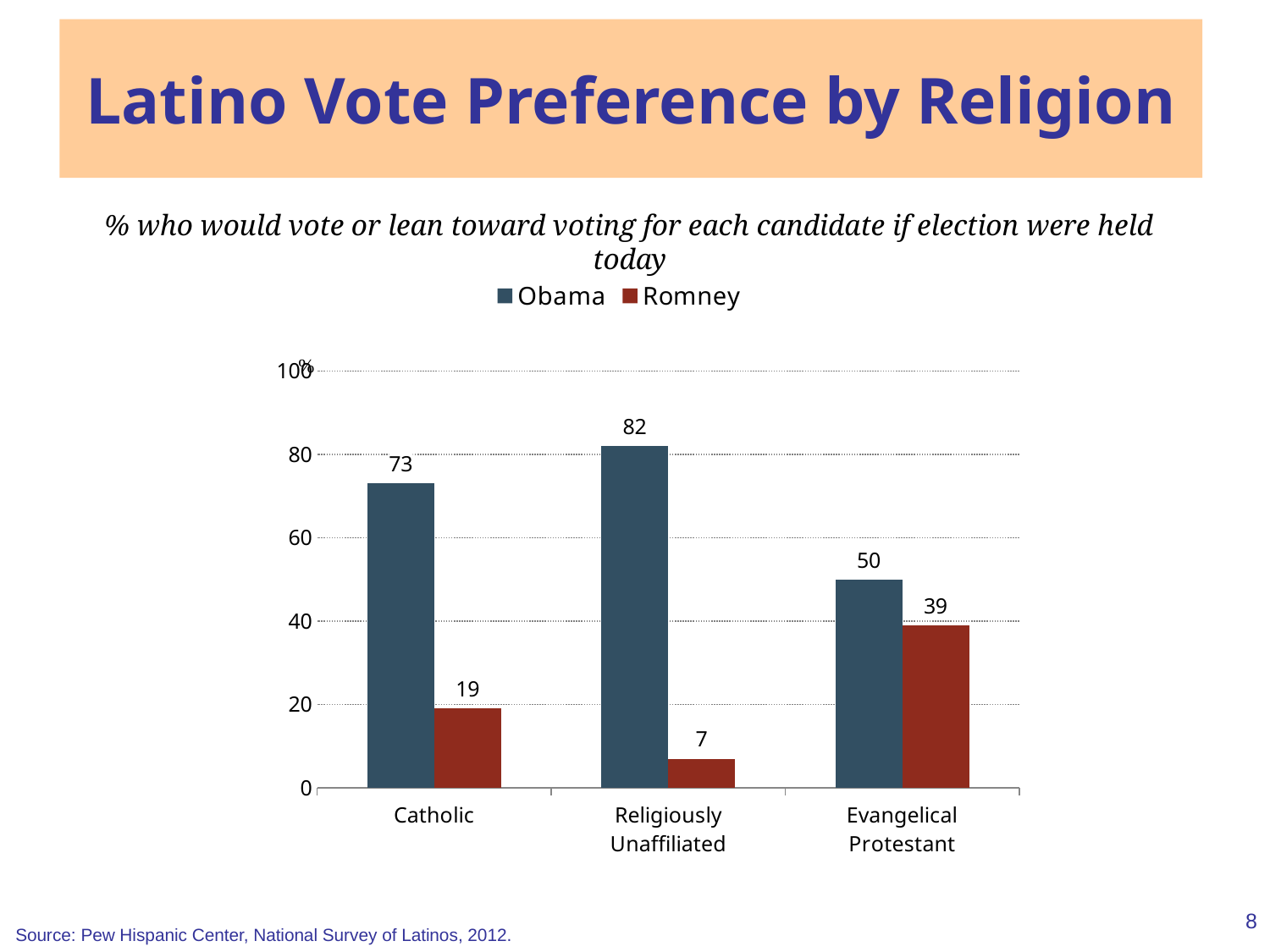
How many religious groups are shown on the x axis? 3 What is the Obama value for Catholic? 73 What is the difference between the Obama values for Religiously Unaffiliated and Catholic? 9 What is the Romney value for Religiously Unaffiliated? 7 What is the difference between the Obama and Romney values for Evangelical Protestant? 11 Which religious group has the lowest Romney value? Religiously Unaffiliated What is the Romney value for Evangelical Protestant? 39 Which series is shown in dark red in the legend? Romney Which is larger, the Romney value for Catholic or the Romney value for Evangelical Protestant? Evangelical Protestant What kind of chart is shown on the slide? Bar chart Which religious group has the highest Obama value? Religiously Unaffiliated How many series does the legend list? 2